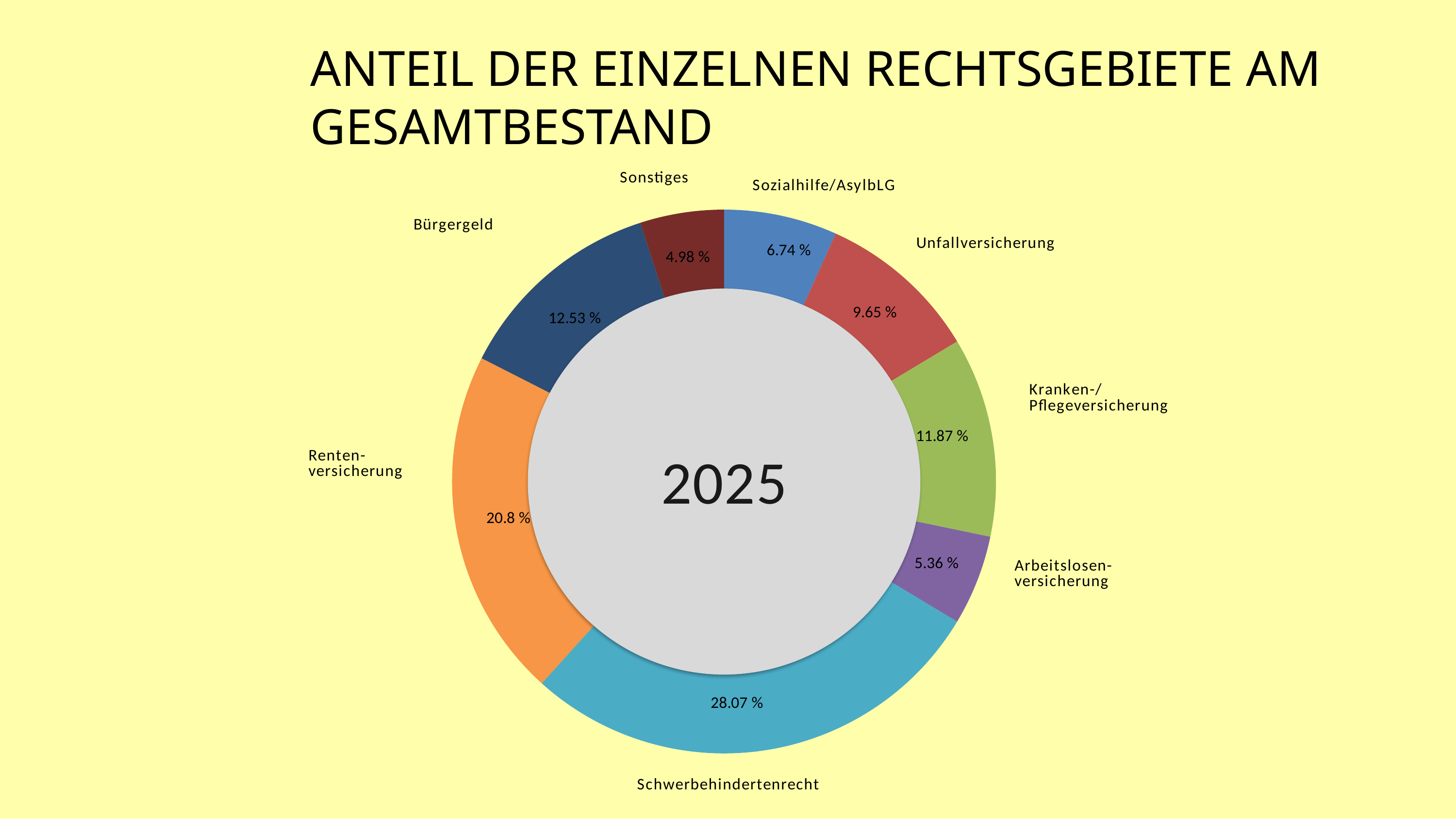
What is the difference between the shares of Schwerbehindertenrecht and Rentenversicherung? 7.27 % How many categories are shown in the chart? 8 Which category has the smallest share in the chart? Sonstiges What percentage is shown for Unfallversicherung? 9.65 % What kind of chart is shown on the slide? Doughnut (pie) chart Which has the larger share, Bürgergeld or Kranken-/Pflegeversicherung? Bürgergeld What is the value shown for Rentenversicherung? 20.8 % What share does Schwerbehindertenrecht have in the chart? 28.07 % What year is displayed in the centre of the chart? 2025 Which category has the largest share in the chart? Schwerbehindertenrecht Which has the larger share, Sozialhilfe/AsylbLG or Unfallversicherung? Unfallversicherung What is the value for Arbeitslosenversicherung? 5.36 %